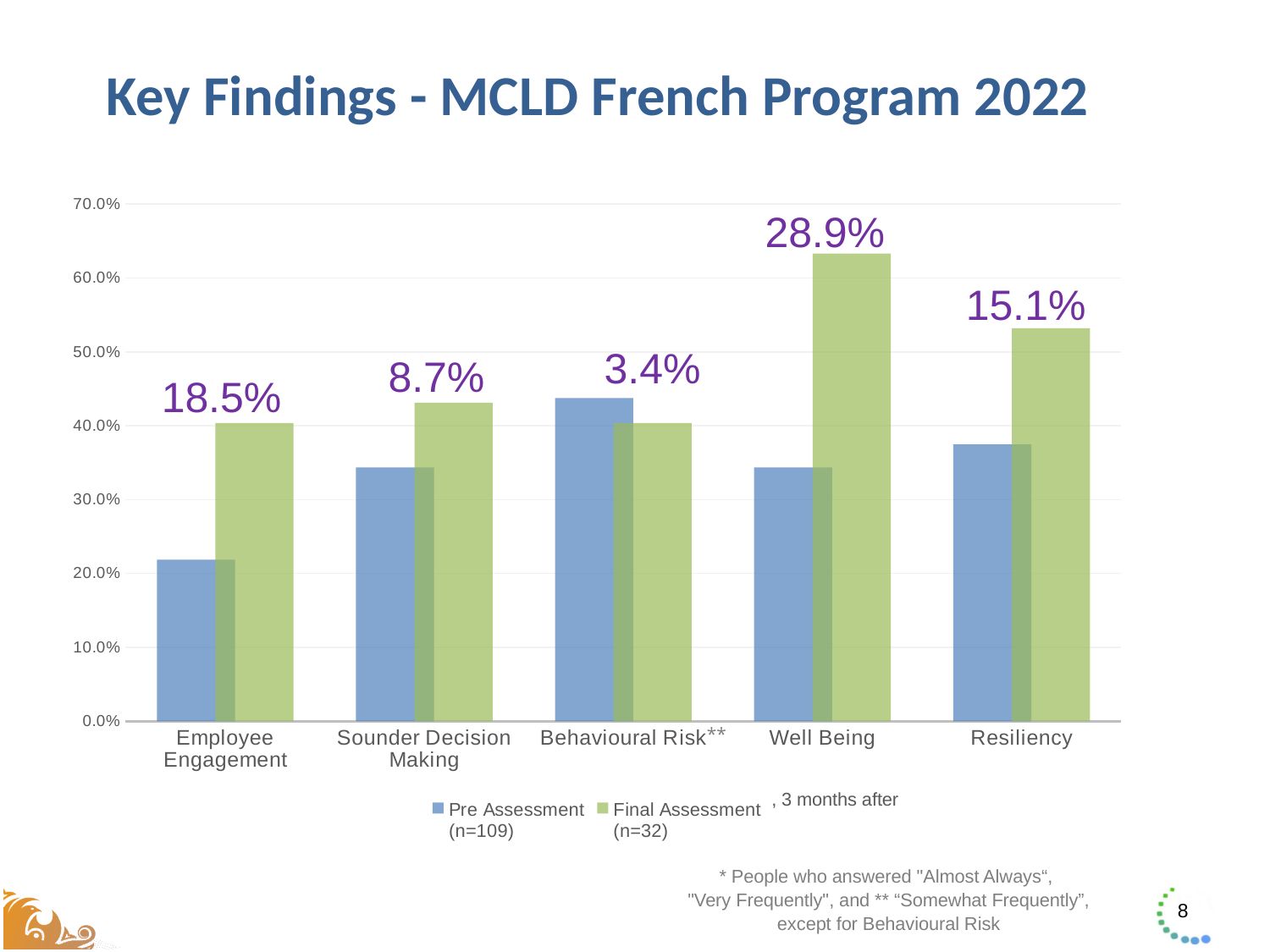
Which category has the lowest Pre Assessment bar? Employee Engagement Which category has the highest Pre Assessment bar? Behavioural Risk** What is the title of the slide containing the chart? Key Findings - MCLD French Program 2022 Is the Pre Assessment value for Employee Engagement greater or less than 30.0%? less Which category has the highest Final Assessment bar? Well Being What percentage is annotated in purple above the Well Being bars? 28.9% How many categories are shown on the x axis of the chart? 5 How many series does the chart's legend list? 2 For Behavioural Risk**, which bar is taller: Pre Assessment or Final Assessment? Pre Assessment What kind of chart is shown on the slide? bar chart Is the Final Assessment value for Resiliency greater or less than 50.0%? greater Is the Final Assessment value for Well Being greater or less than 60.0%? greater